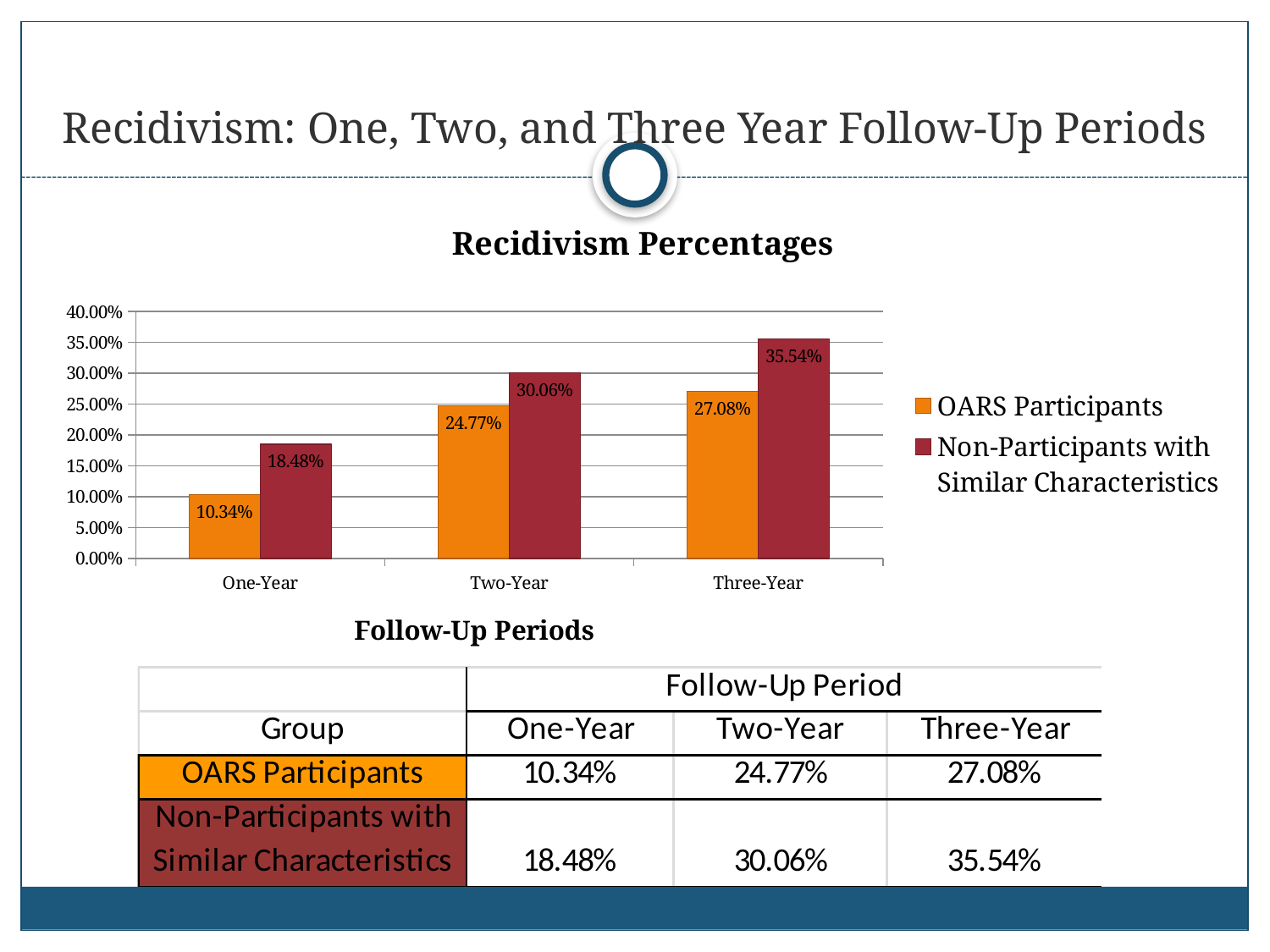
How many follow-up periods are shown on the x axis of the chart? 3 What is the recidivism percentage for OARS Participants at the Two-Year follow-up? 24.77% What is the difference between the Non-Participants and OARS Participants recidivism percentages at the Three-Year follow-up? 8.46% What is the recidivism percentage for Non-Participants with Similar Characteristics at the Three-Year follow-up? 35.54% Do the recidivism percentages for OARS Participants rise or fall from One-Year to Three-Year? Rise Which follow-up period has the highest recidivism percentage for Non-Participants with Similar Characteristics? Three-Year What type of chart is used to show the recidivism percentages? Bar chart Which follow-up period has the lowest recidivism percentage for OARS Participants? One-Year Is the Two-Year recidivism percentage for Non-Participants with Similar Characteristics greater or less than 25.00%? greater At the Two-Year follow-up, which group has the higher recidivism percentage? Non-Participants with Similar Characteristics How many series does the chart legend list? 2 What is the recidivism percentage for OARS Participants at the One-Year follow-up? 10.34%